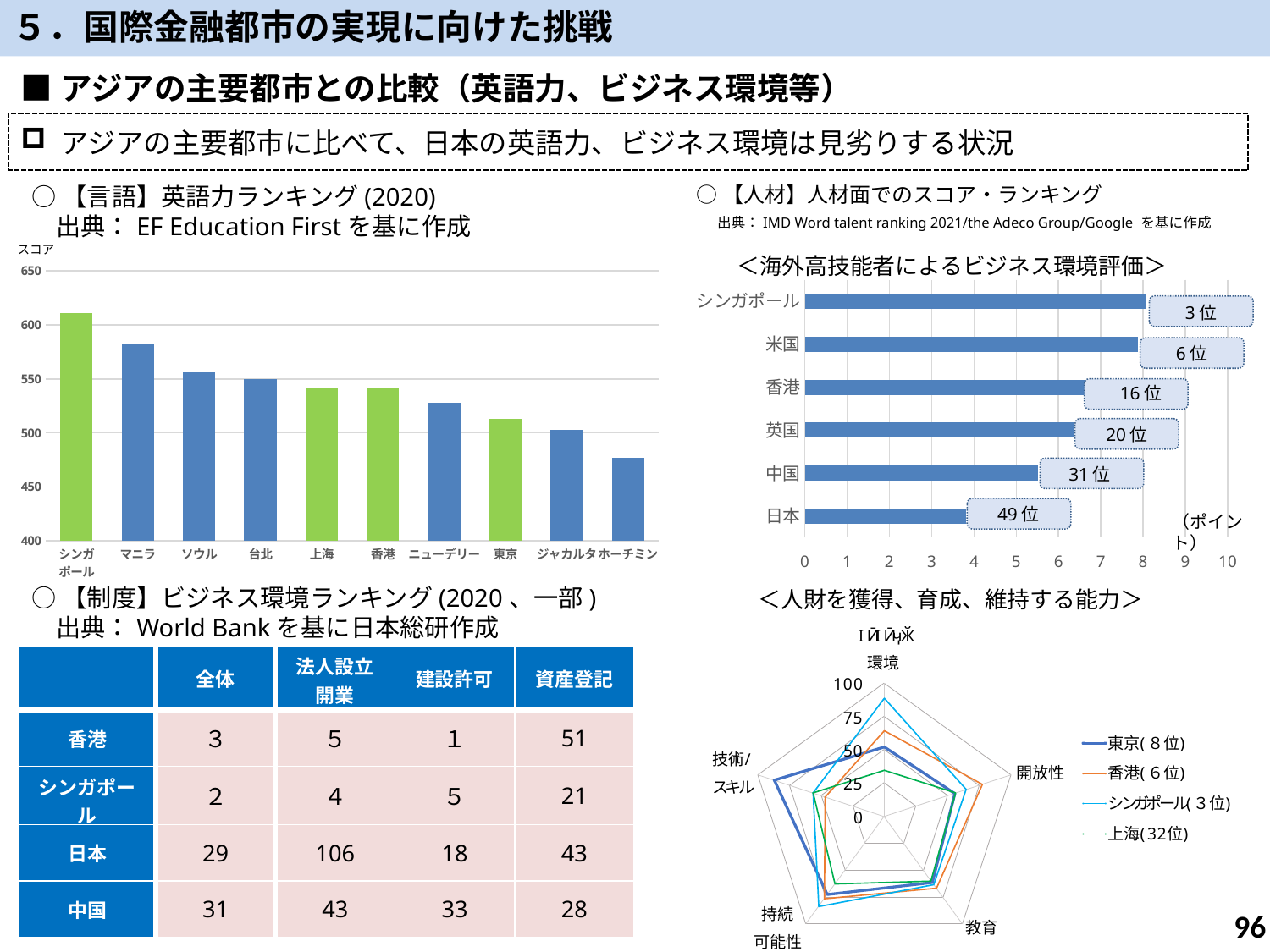
In the 海外高技能者によるビジネス環境評価 chart, which country or region has the longest bar? シンガポール In the 海外高技能者によるビジネス環境評価 chart, how many countries or regions are shown? 6 In the English proficiency ranking bar chart (英語力ランキング), do the scores rise or fall from left to right? fall In the English proficiency ranking bar chart (英語力ランキング), is the score for ホーチミン greater or less than 500? less In the English proficiency ranking bar chart (英語力ランキング), is the score for シンガポール greater or less than 600? greater In the 海外高技能者によるビジネス環境評価 chart, is the value for 日本 greater or less than 5? less In the English proficiency ranking bar chart (英語力ランキング), how many cities are shown? 10 In the English proficiency ranking bar chart (英語力ランキング), which city has the lowest score? ホーチミン In the 人財を獲得、育成、維持する能力 radar chart, how many series does the legend list? 4 In the English proficiency ranking bar chart (英語力ランキング), which city has the highest score? シンガポール In the 海外高技能者によるビジネス環境評価 chart, what rank label is shown for 日本? 49位 In the English proficiency ranking bar chart (英語力ランキング), which has the higher score, マニラ or 東京? マニラ